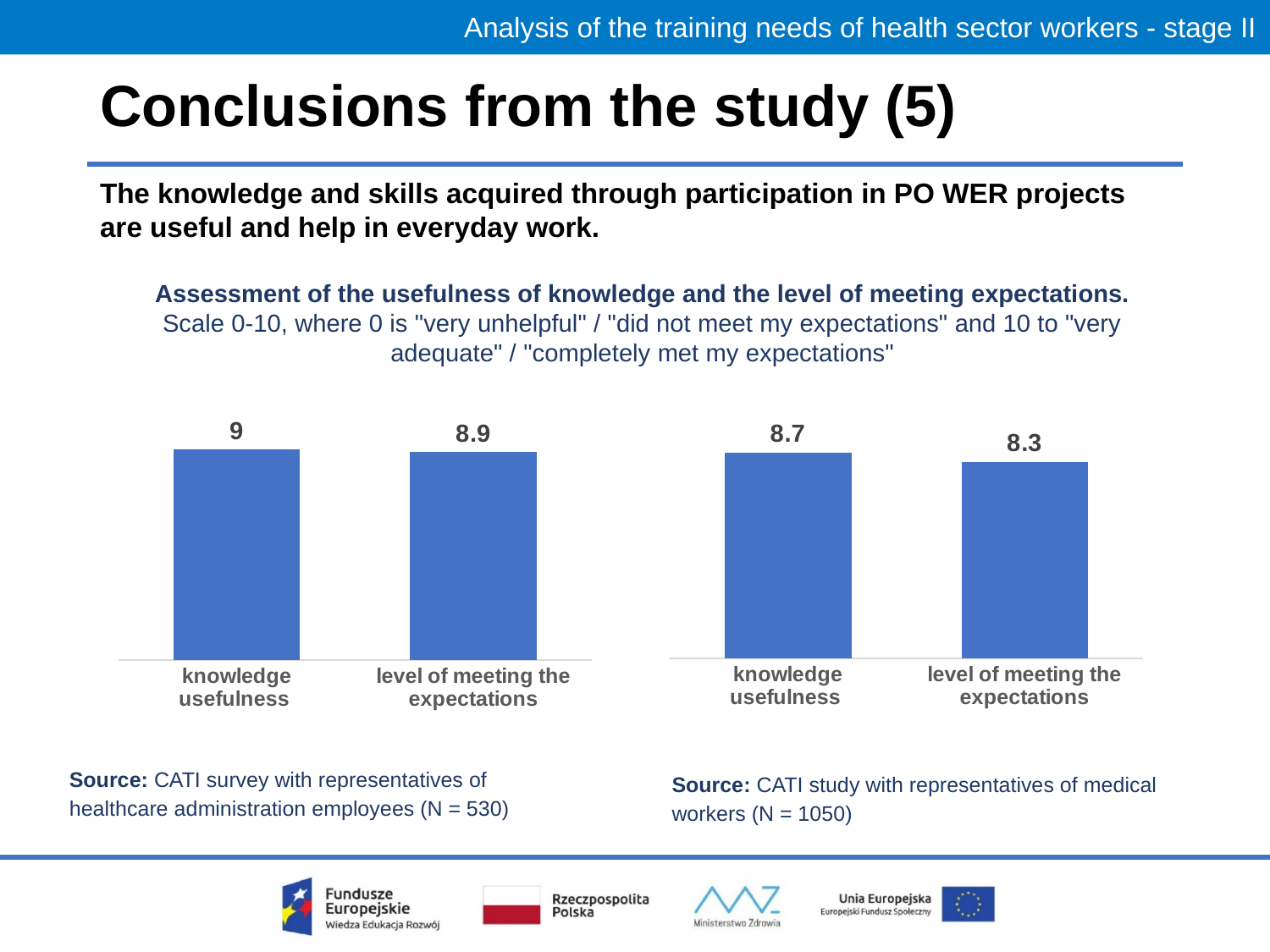
In the left chart, what is the value for knowledge usefulness? 9 Which is larger: knowledge usefulness in the left chart or knowledge usefulness in the right chart? left chart In the right chart, what is the value for level of meeting the expectations? 8.3 In the right chart, which category has the highest value? knowledge usefulness In the right chart, which category has the lowest value? level of meeting the expectations How many categories are shown in the left chart? 2 In the right chart, what is the value for knowledge usefulness? 8.7 In the left chart, what is the value for level of meeting the expectations? 8.9 What kind of chart is the right chart? bar chart What colour are the bars in the left chart? blue In the right chart, what is the difference between knowledge usefulness and level of meeting the expectations? 0.4 In the left chart, what is the difference between knowledge usefulness and level of meeting the expectations? 0.1